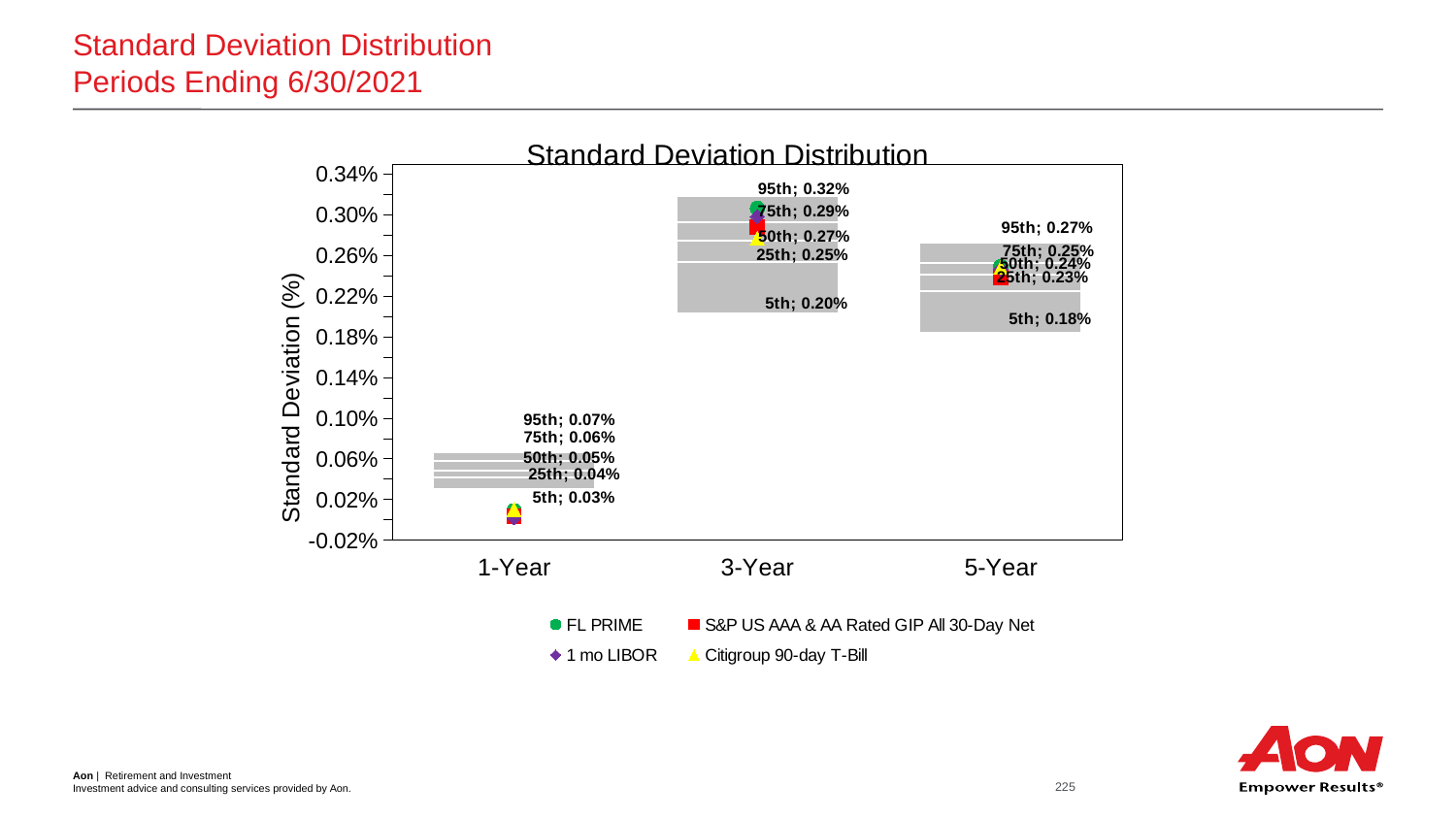
What is the difference between the 50th percentile standard deviation for the 3-Year period and the 5-Year period? 0.03% What is the difference between the 95th and 5th percentile standard deviations for the 3-Year period? 0.12% What is the title of the chart? Standard Deviation Distribution How many periods are shown on the x axis? 3 Which is larger, the 75th percentile standard deviation for the 3-Year period or for the 5-Year period? 3-Year What is the 50th percentile standard deviation for the 1-Year period? 0.05% What is the 25th percentile standard deviation for the 3-Year period? 0.25% What is the 5th percentile standard deviation for the 5-Year period? 0.18% How many series does the legend list? 4 What is the 95th percentile standard deviation for the 3-Year period? 0.32% Which period has the lowest 5th percentile standard deviation? 1-Year Which period has the highest 95th percentile standard deviation? 3-Year